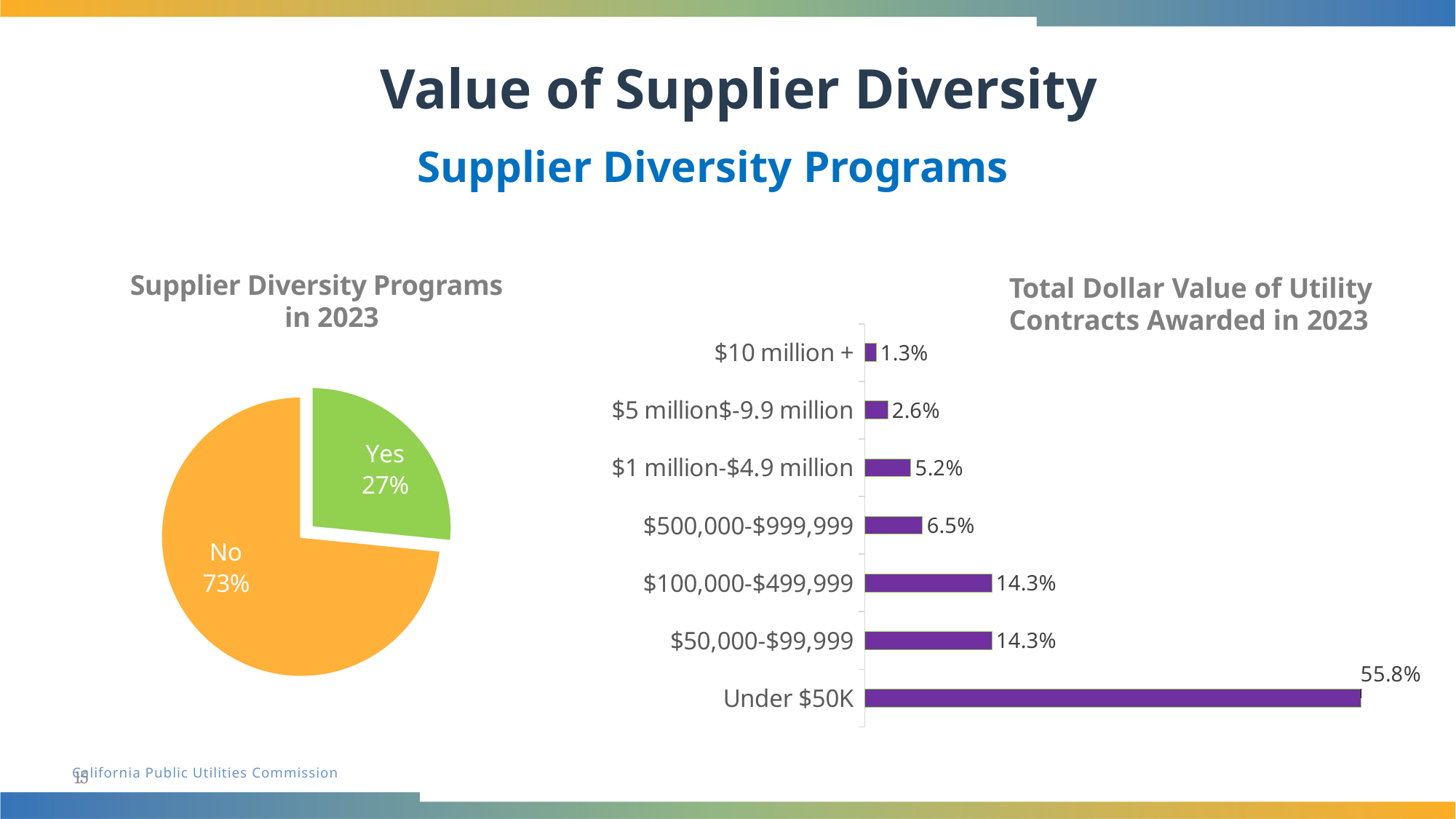
In the 'Total Dollar Value of Utility Contracts Awarded in 2023' chart, what is the difference between the values for $1 million-$4.9 million and $5 million$-9.9 million? 2.6% In the 'Total Dollar Value of Utility Contracts Awarded in 2023' chart, what is the value for Under $50K? 55.8% In the 'Total Dollar Value of Utility Contracts Awarded in 2023' chart, what is the value for $500,000-$999,999? 6.5% What kind of chart is 'Total Dollar Value of Utility Contracts Awarded in 2023'? Bar chart In the 'Total Dollar Value of Utility Contracts Awarded in 2023' chart, what colour are the bars? Purple In the 'Supplier Diversity Programs in 2023' chart, what percentage of respondents answered No? 73% In the 'Supplier Diversity Programs in 2023' chart, which slice is larger, Yes or No? No What kind of chart is 'Supplier Diversity Programs in 2023'? Pie chart In the 'Supplier Diversity Programs in 2023' chart, what percentage of respondents answered Yes? 27% In the 'Total Dollar Value of Utility Contracts Awarded in 2023' chart, which category has the lowest value? $10 million + In the 'Total Dollar Value of Utility Contracts Awarded in 2023' chart, which category has the highest value? Under $50K In the 'Total Dollar Value of Utility Contracts Awarded in 2023' chart, how many categories are shown? 7